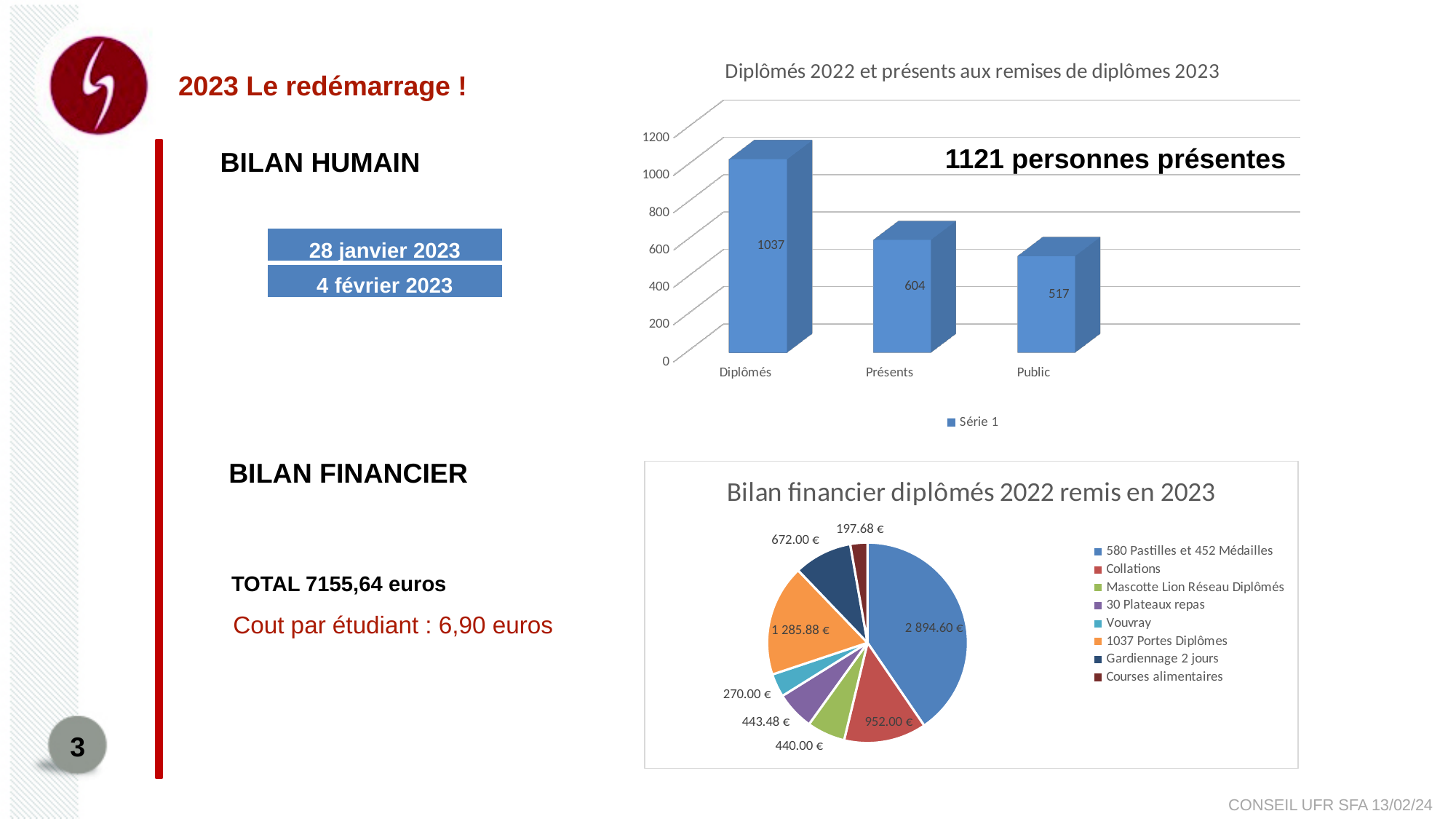
In the bar chart 'Diplômés 2022 et présents aux remises de diplômes 2023', what is the value for Public? 517 In the bar chart 'Diplômés 2022 et présents aux remises de diplômes 2023', do the values rise or fall from left to right? fall In the bar chart 'Diplômés 2022 et présents aux remises de diplômes 2023', what is the value for Diplômés? 1037 What type of chart is 'Diplômés 2022 et présents aux remises de diplômes 2023'? bar chart In the bar chart 'Diplômés 2022 et présents aux remises de diplômes 2023', how many categories are shown on the x axis? 3 In the bar chart 'Diplômés 2022 et présents aux remises de diplômes 2023', what is the difference between Diplômés and Présents? 433 In the pie chart 'Bilan financier diplômés 2022 remis en 2023', which category has the largest slice? 580 Pastilles et 452 Médailles In the pie chart 'Bilan financier diplômés 2022 remis en 2023', which is larger: Gardiennage 2 jours or Vouvray? Gardiennage 2 jours In the pie chart 'Bilan financier diplômés 2022 remis en 2023', what is the value for Collations? 952.00 € In the bar chart 'Diplômés 2022 et présents aux remises de diplômes 2023', which category has the lowest value? Public In the pie chart 'Bilan financier diplômés 2022 remis en 2023', what is the value for 1037 Portes Diplômes? 1 285.88 € How many entries does the legend of the pie chart 'Bilan financier diplômés 2022 remis en 2023' list? 8